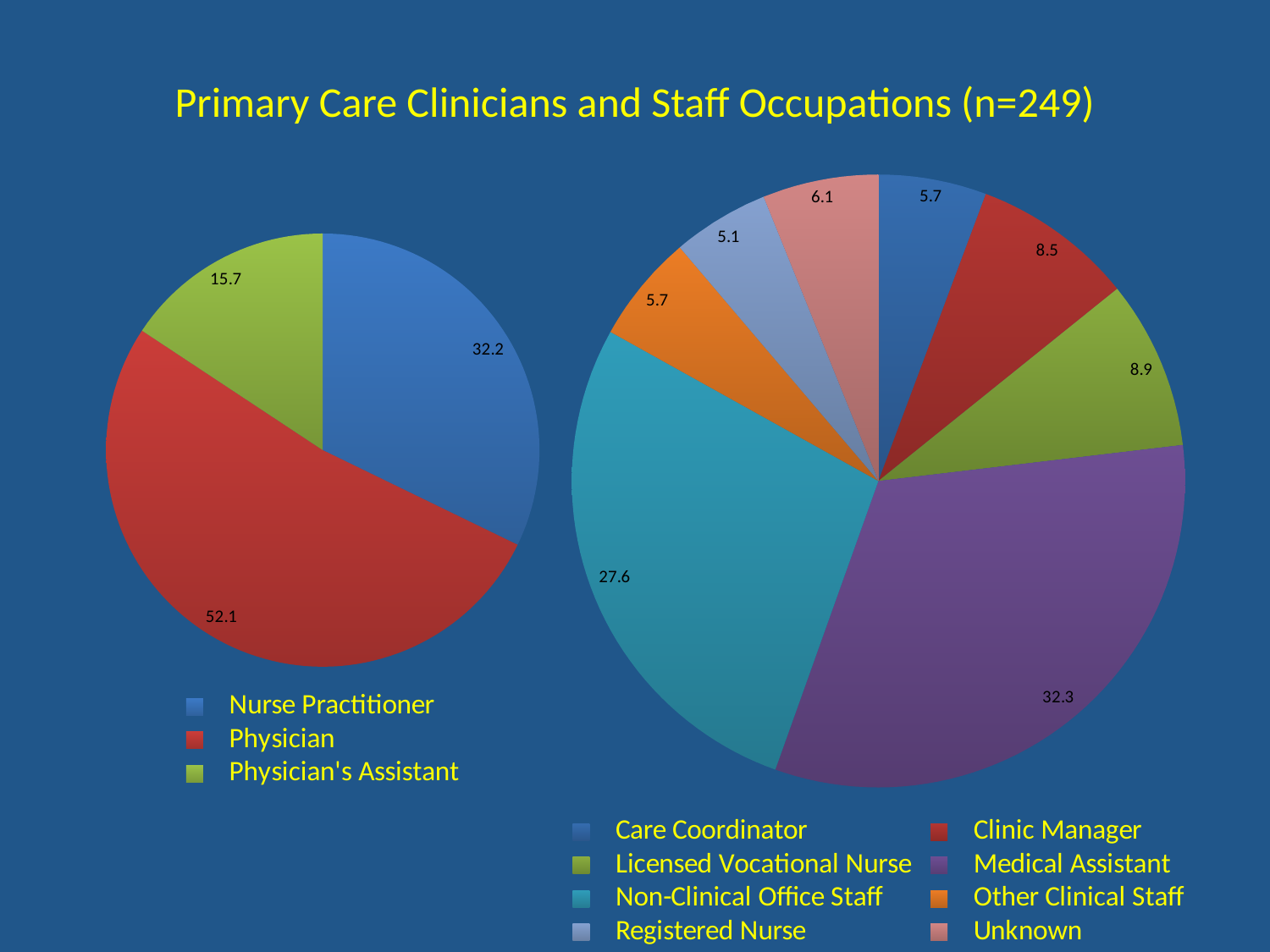
On the right pie chart, which is larger, Licensed Vocational Nurse or Clinic Manager? Licensed Vocational Nurse On the left pie chart, what is the value for Physician's Assistant? 15.7 On the right pie chart, what is the difference between the Medical Assistant and Non-Clinical Office Staff values? 4.7 On the left pie chart, which category has the largest slice? Physician On the right pie chart, what is the value for Medical Assistant? 32.3 How many categories does the right pie chart's legend list? 8 On the left pie chart, what is the value for Physician? 52.1 On the right pie chart, which category has the smallest slice? Registered Nurse What type of chart is shown on the right side of the slide? Pie chart On the right pie chart, what is the value for Non-Clinical Office Staff? 27.6 On the left pie chart, what is the difference between the Physician and Nurse Practitioner values? 19.9 How many categories does the left pie chart's legend list? 3